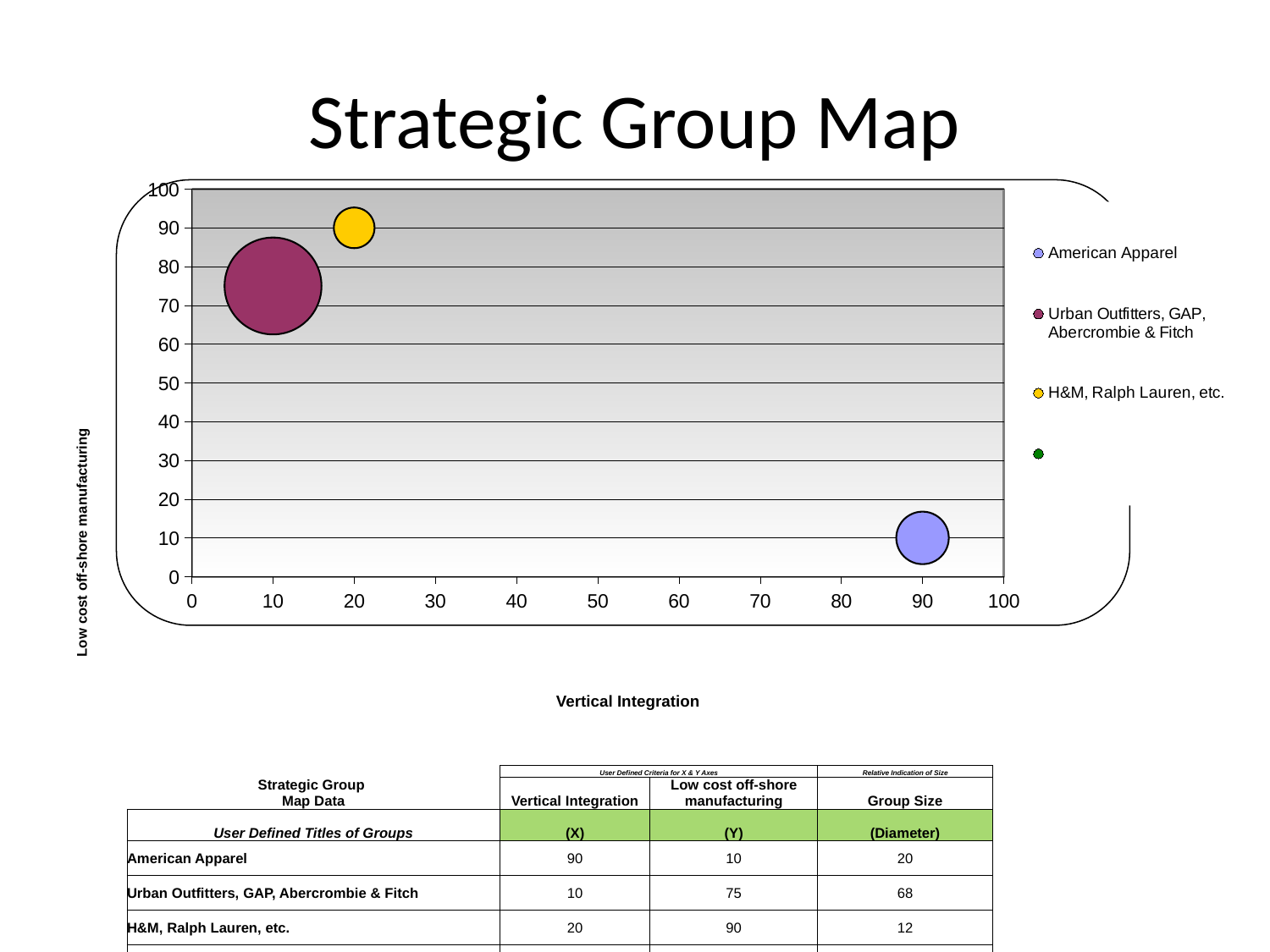
Which group has the lowest Low cost off-shore manufacturing (Y) value? American Apparel What is the Vertical Integration (X) value for American Apparel? 90 What kind of chart is shown on the slide? bubble chart What colour is the bubble for H&M, Ralph Lauren, etc.? yellow How many bubbles are plotted on the chart? 3 What is the Group Size (Diameter) for H&M, Ralph Lauren, etc.? 12 What is the Low cost off-shore manufacturing (Y) value for Urban Outfitters, GAP, Abercrombie & Fitch? 75 What is the label of the horizontal axis of the chart? Vertical Integration What is the difference between the Group Size of Urban Outfitters, GAP, Abercrombie & Fitch and that of American Apparel? 48 Is the Low cost off-shore manufacturing value for H&M, Ralph Lauren, etc. greater or less than 50? greater Which has a higher Vertical Integration (X) value: American Apparel or H&M, Ralph Lauren, etc.? American Apparel Which group has the largest Group Size (Diameter)? Urban Outfitters, GAP, Abercrombie & Fitch